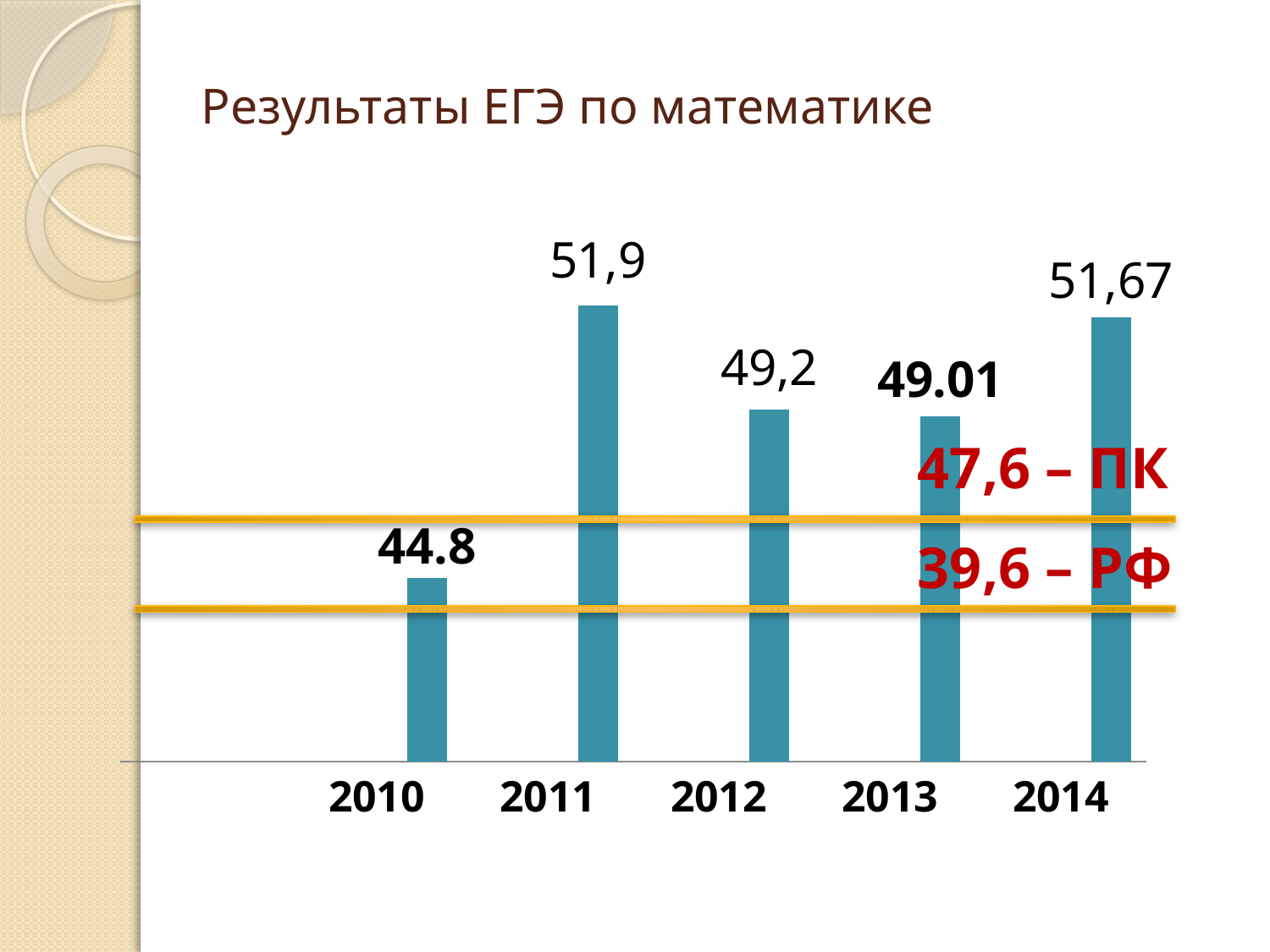
How many years are shown on the x axis? 5 What is the value for 2010? 44.8 What is the value for 2014? 51,67 What is the value for 2011? 51,9 Which year has the lowest value? 2010 What kind of chart is shown on the slide? bar chart What value is marked for ПК by the upper reference line? 47,6 Which year has the highest value? 2011 Which is larger, the value for 2011 or the value for 2013? 2011 What is the title of the chart? Результаты ЕГЭ по математике What is the value for 2013? 49.01 What is the difference between the values for 2011 and 2012? 2,7